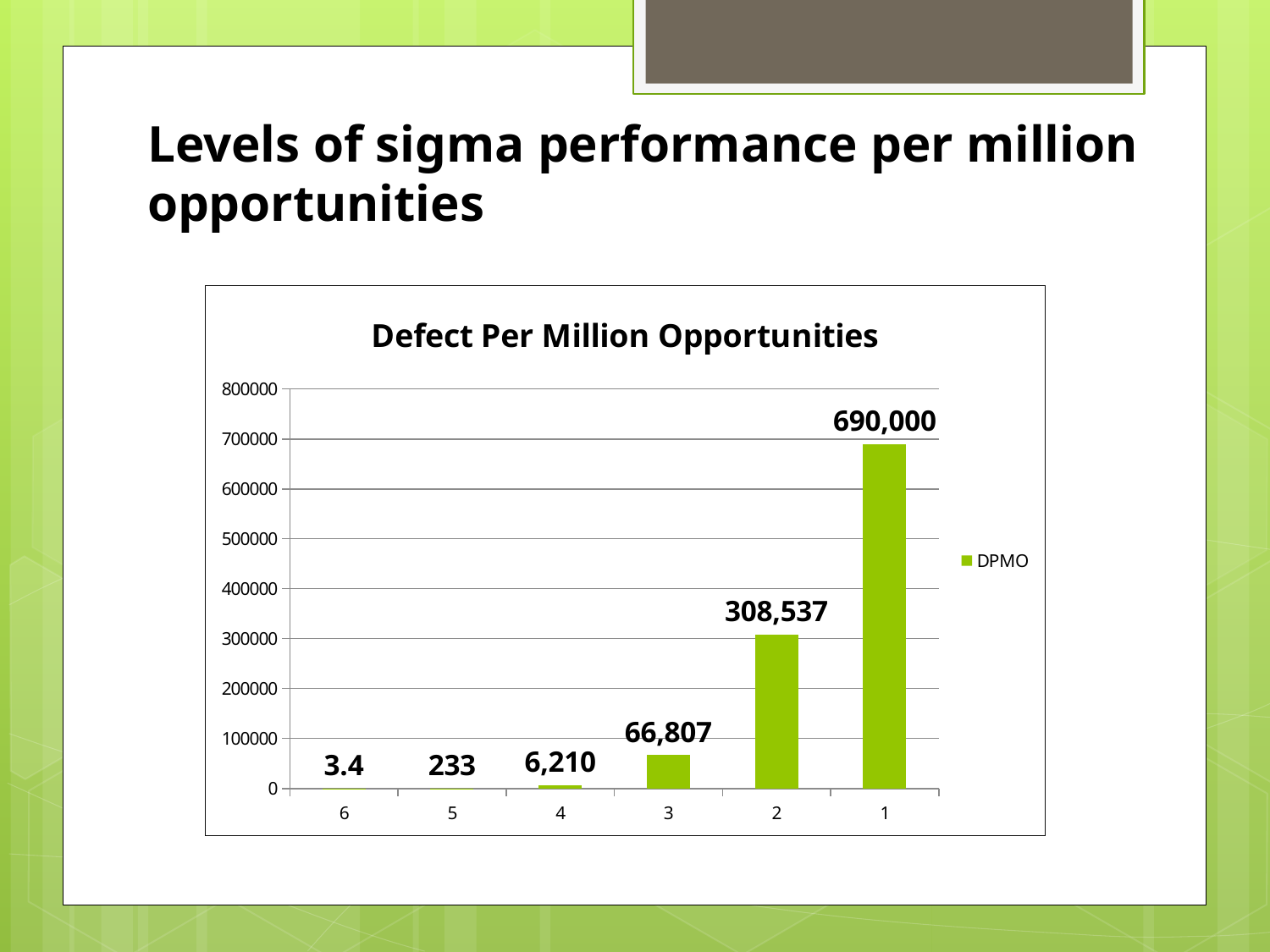
How many series does the legend list? 1 How many sigma levels are shown on the x axis? 6 What is the title of the chart? Defect Per Million Opportunities What is the DPMO value for sigma level 3? 66,807 What is the DPMO value for sigma level 6? 3.4 What is the difference between the DPMO values for sigma levels 1 and 2? 381,463 Which sigma level has the lowest DPMO value? 6 What kind of chart is shown? bar chart Which sigma level has the highest DPMO value? 1 What is the DPMO value for sigma level 2? 308,537 Is the DPMO value for sigma level 1 greater or less than 600000? greater Which has a larger DPMO value, sigma level 4 or sigma level 5? 4